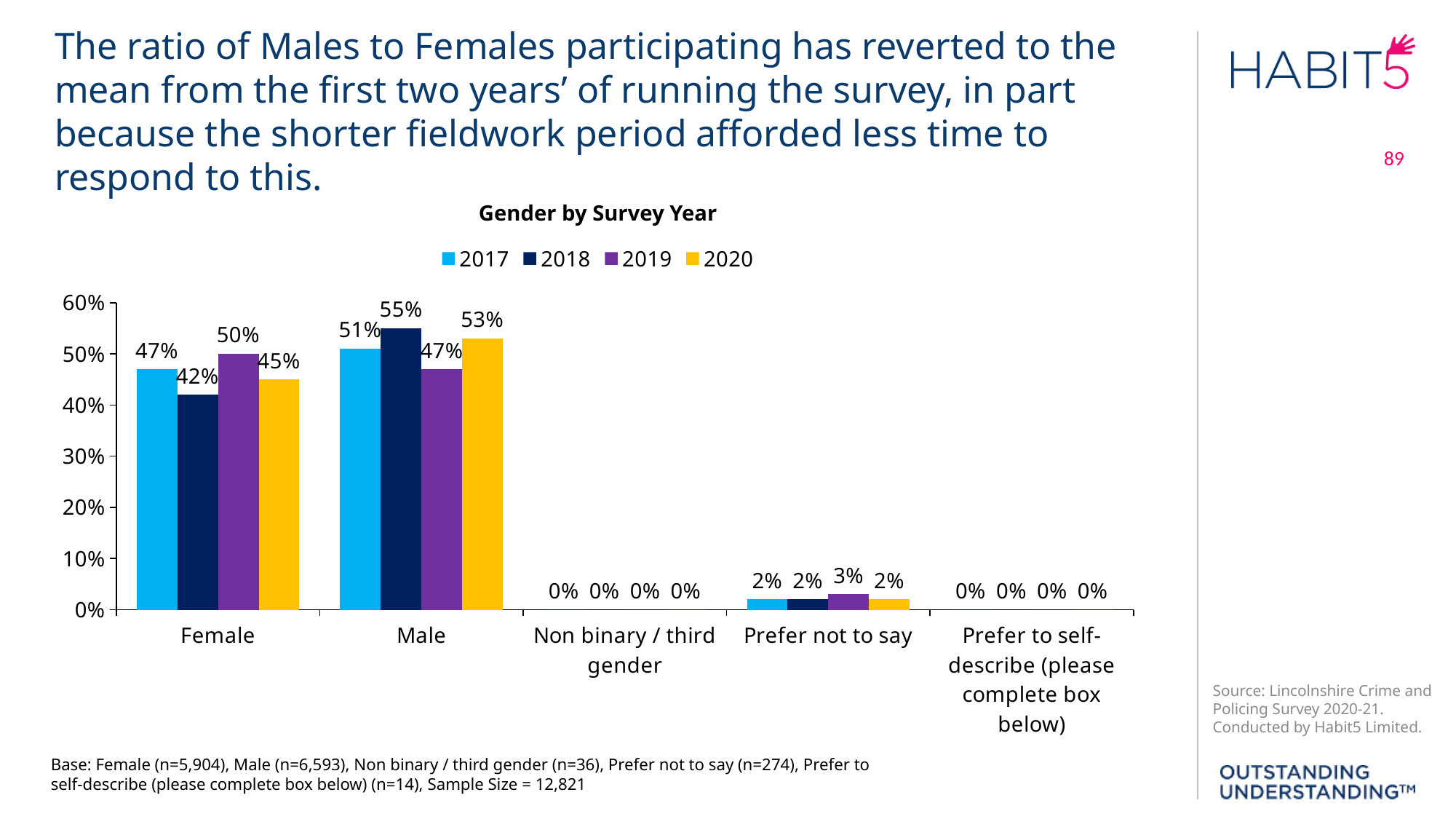
What is the title of the chart? Gender by Survey Year What is the value for Female in 2018? 42% What is the value for Male in 2020? 53% What is the difference between the Male and Female values in 2020? 8% Which survey year has the highest value for Male? 2018 How many gender categories are shown on the x axis? 5 How many series does the legend list? 4 Which survey year has the lowest value for Female? 2018 What is the value for Prefer not to say in 2019? 3% Which is larger in 2019: the Female value or the Male value? Female Is the value for Female in 2017 greater or less than 40%? greater What kind of chart is shown on the slide? bar chart